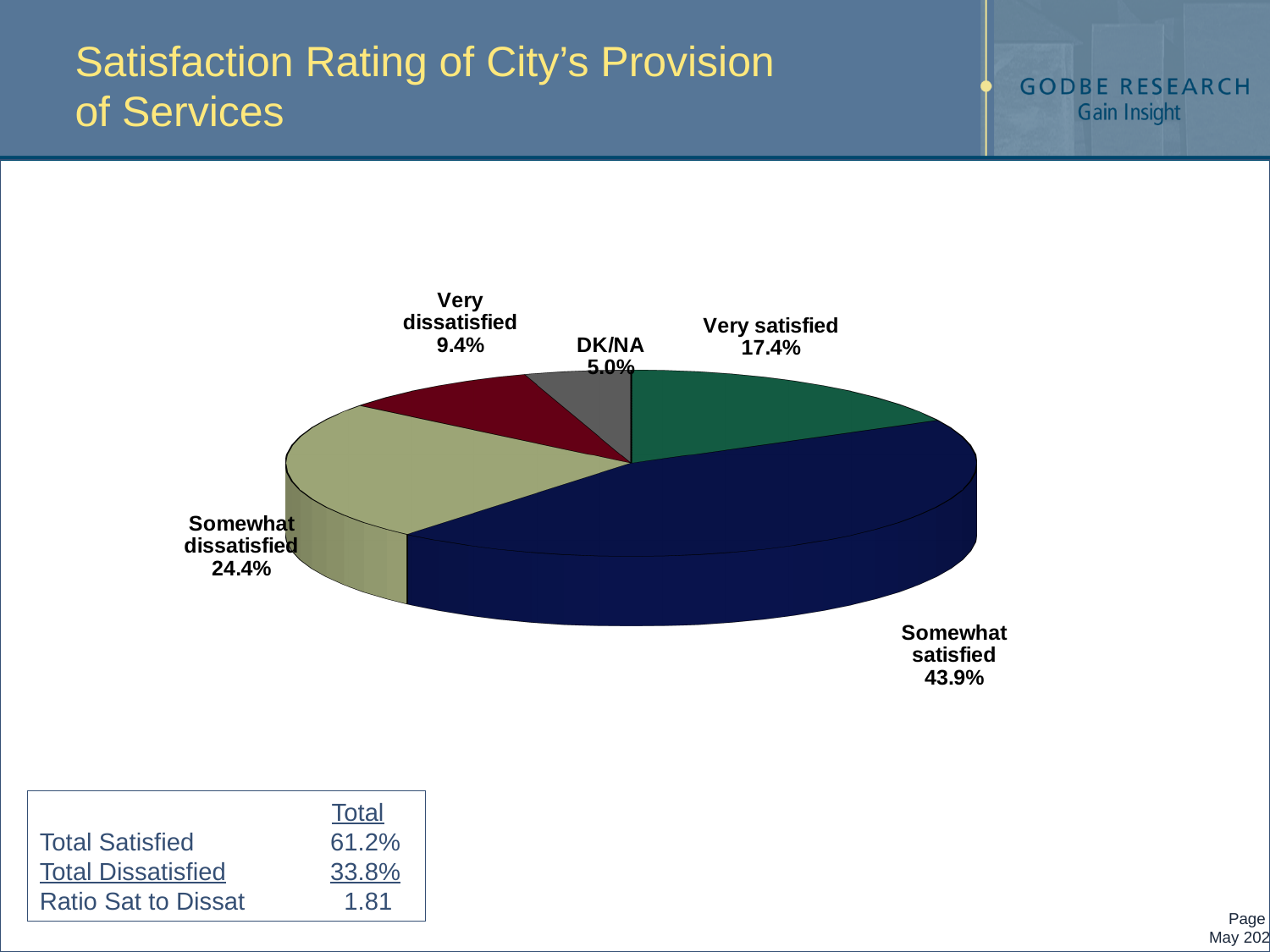
What is the difference between the somewhat satisfied and somewhat dissatisfied percentages? 19.5% Which category has the smallest share of the pie? DK/NA What is the title of the slide containing the chart? Satisfaction Rating of City's Provision of Services Which category has the largest share of the pie? Somewhat satisfied How many slices does the pie chart have? 5 What percentage of respondents are somewhat satisfied? 43.9% What is the combined share of very satisfied and somewhat satisfied respondents? 61.3% Which is larger, the very satisfied share or the very dissatisfied share? Very satisfied What is the value for the DK/NA slice? 5.0% What percentage of respondents are very satisfied? 17.4% What kind of chart is shown on the slide? pie chart What percentage of respondents are very dissatisfied? 9.4%